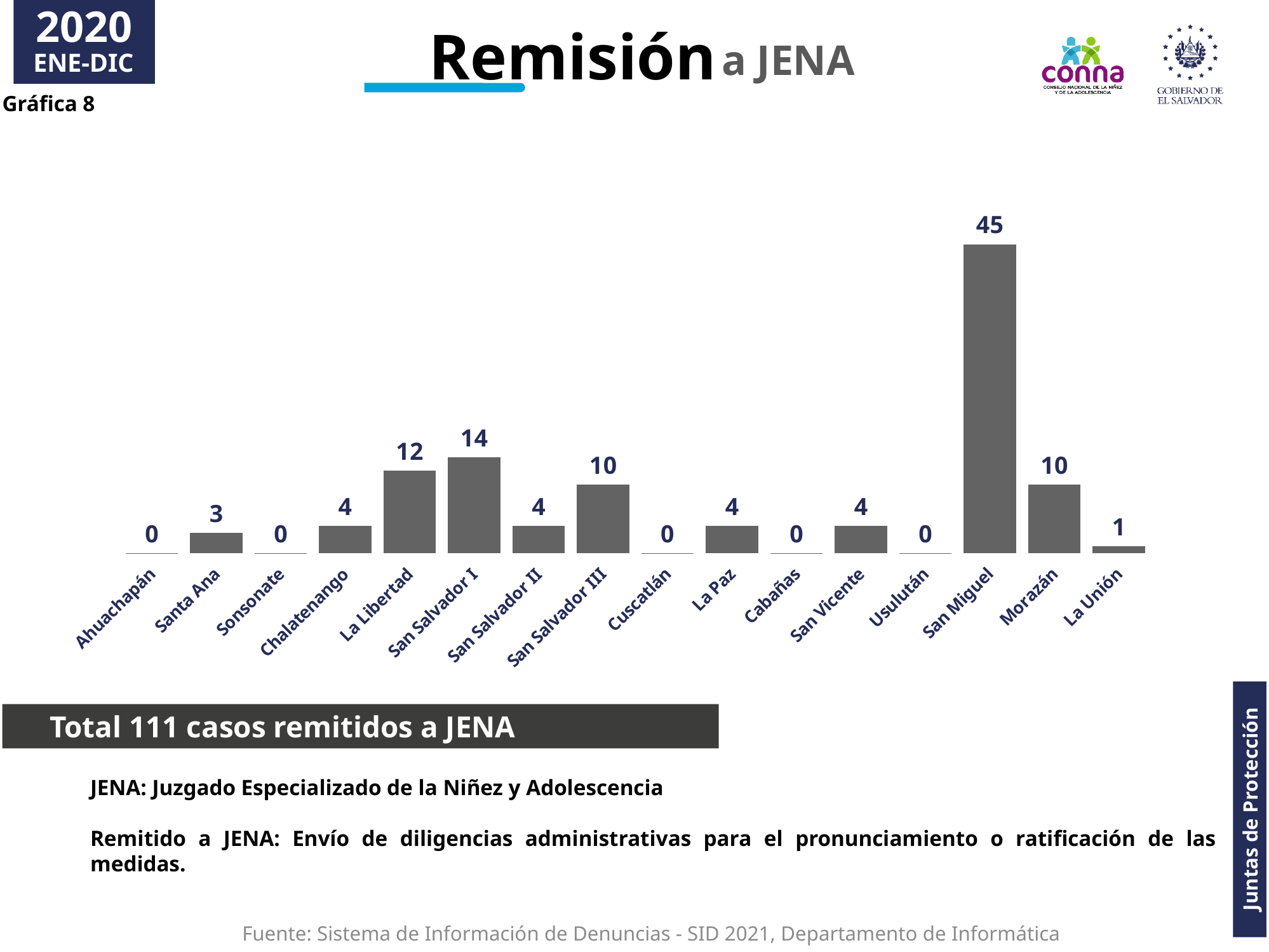
What is the difference between the values for La Libertad and Santa Ana? 9 What is the value for La Libertad? 12 What is the value for La Unión? 1 What is the value for San Miguel? 45 How many categories are shown on the x axis? 16 Which is larger, the value for San Salvador III or the value for San Salvador II? San Salvador III What is the difference between the values for San Miguel and San Salvador I? 31 How many categories have a value of 0? 5 What is the value for San Salvador I? 14 Which category has the highest value? San Miguel What total number of cases remitted to JENA is stated on the slide? 111 What kind of chart is shown on the slide? bar chart